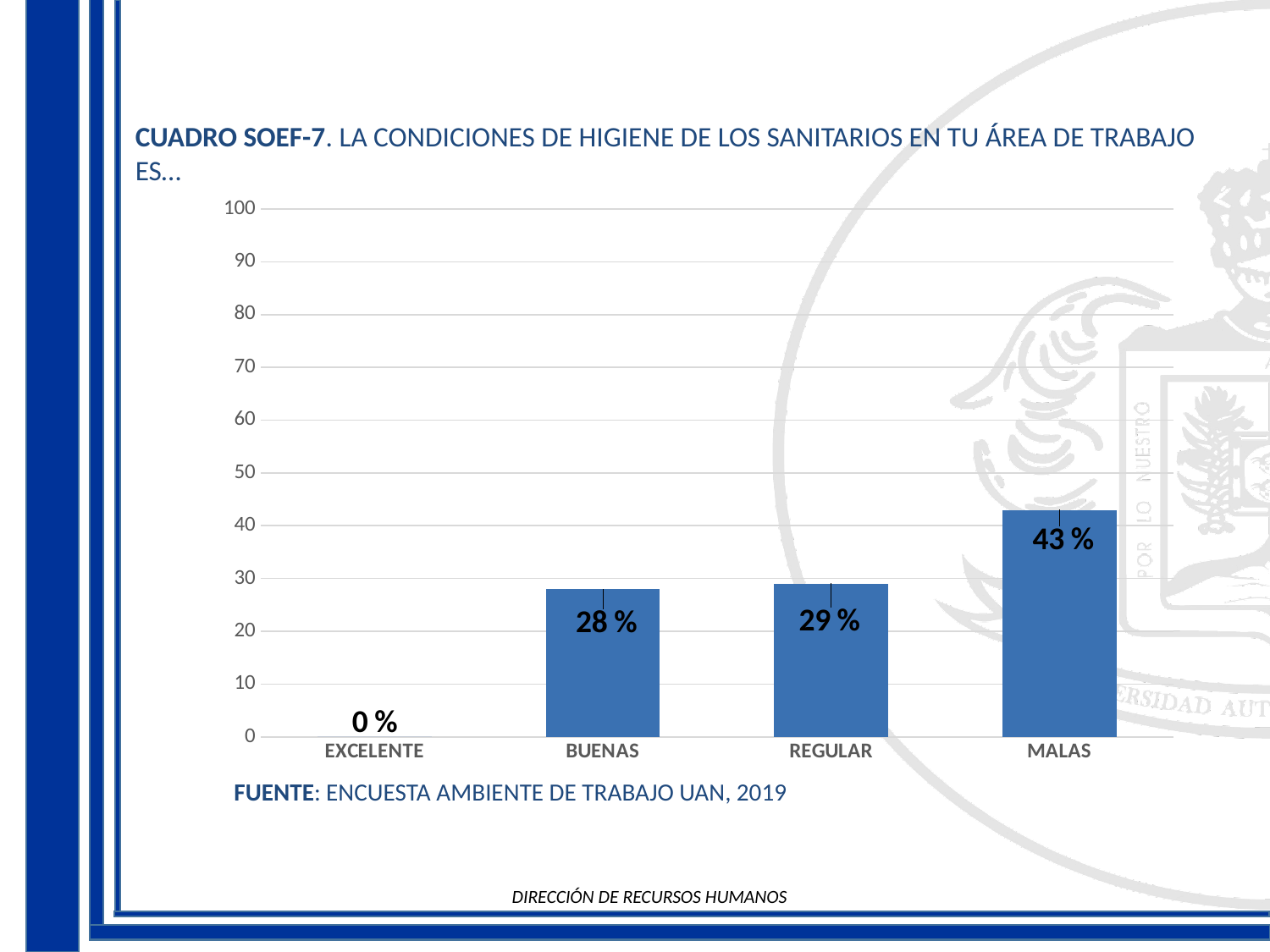
Which is larger, the value for MALAS or the value for REGULAR? MALAS What is the value for REGULAR? 29 % What is the value for BUENAS? 28 % What is the value for EXCELENTE? 0 % Is the value for MALAS greater or less than 40? greater What kind of chart is shown on the slide? bar chart Which category has the highest value? MALAS How many categories are shown on the x axis? 4 Which category has the lowest value? EXCELENTE What is the difference between the values for MALAS and BUENAS? 15 % What is the value for MALAS? 43 % What source is cited below the chart? ENCUESTA AMBIENTE DE TRABAJO UAN, 2019